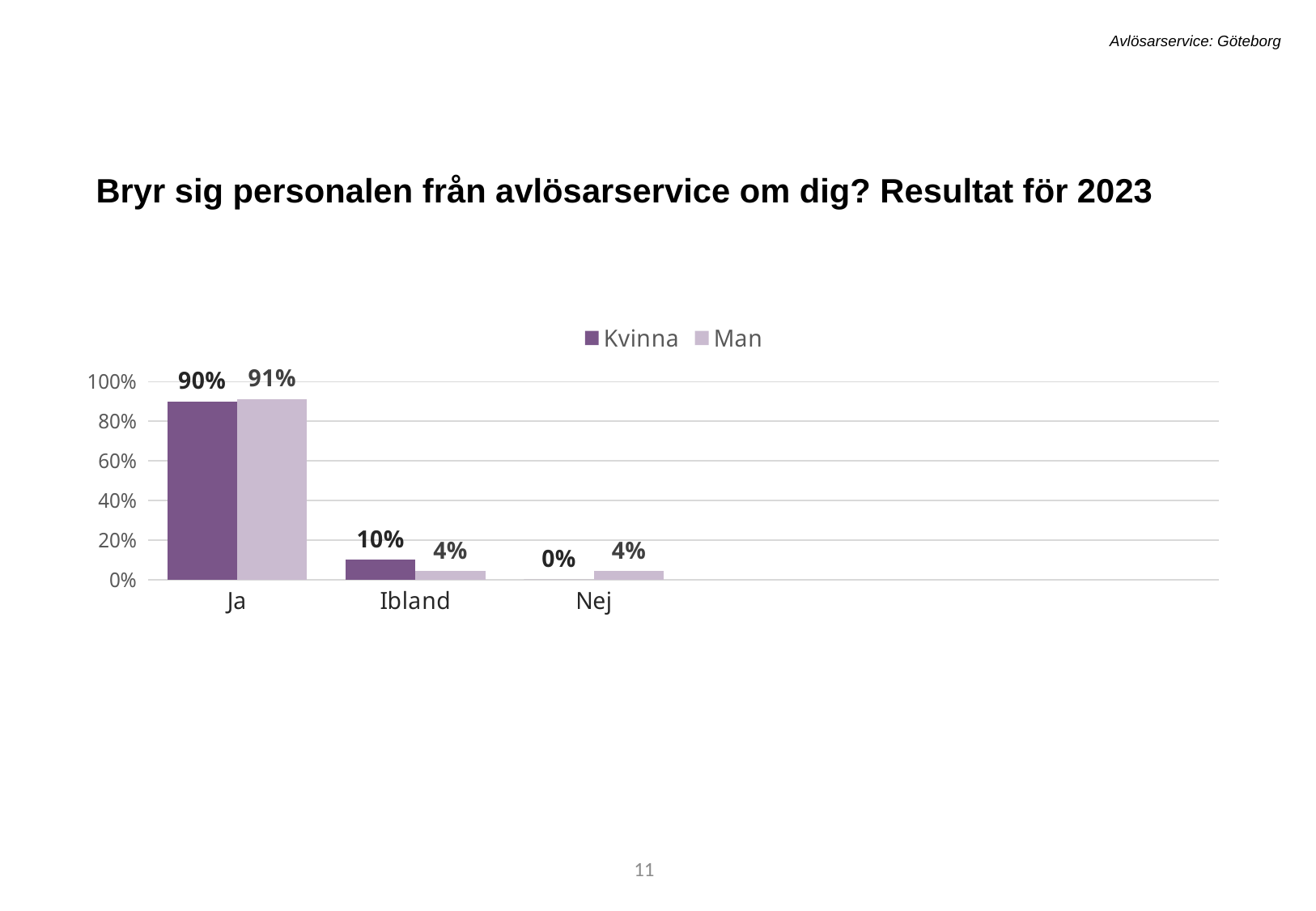
What is the value for Kvinna in the Ja category? 90% What is the value for Kvinna in the Nej category? 0% What kind of chart is shown on the slide? Bar chart What is the value for Man in the Nej category? 4% Which category has the highest value for the Kvinna series? Ja What is the difference between the Kvinna and Man values in the Ibland category? 6% How many series does the legend list? 2 Which category has the lowest value for the Kvinna series? Nej What is the value for Kvinna in the Ibland category? 10% What is the value for Man in the Ja category? 91% How many categories are shown on the x axis? 3 Which is larger in the Ibland category, the Kvinna value or the Man value? Kvinna